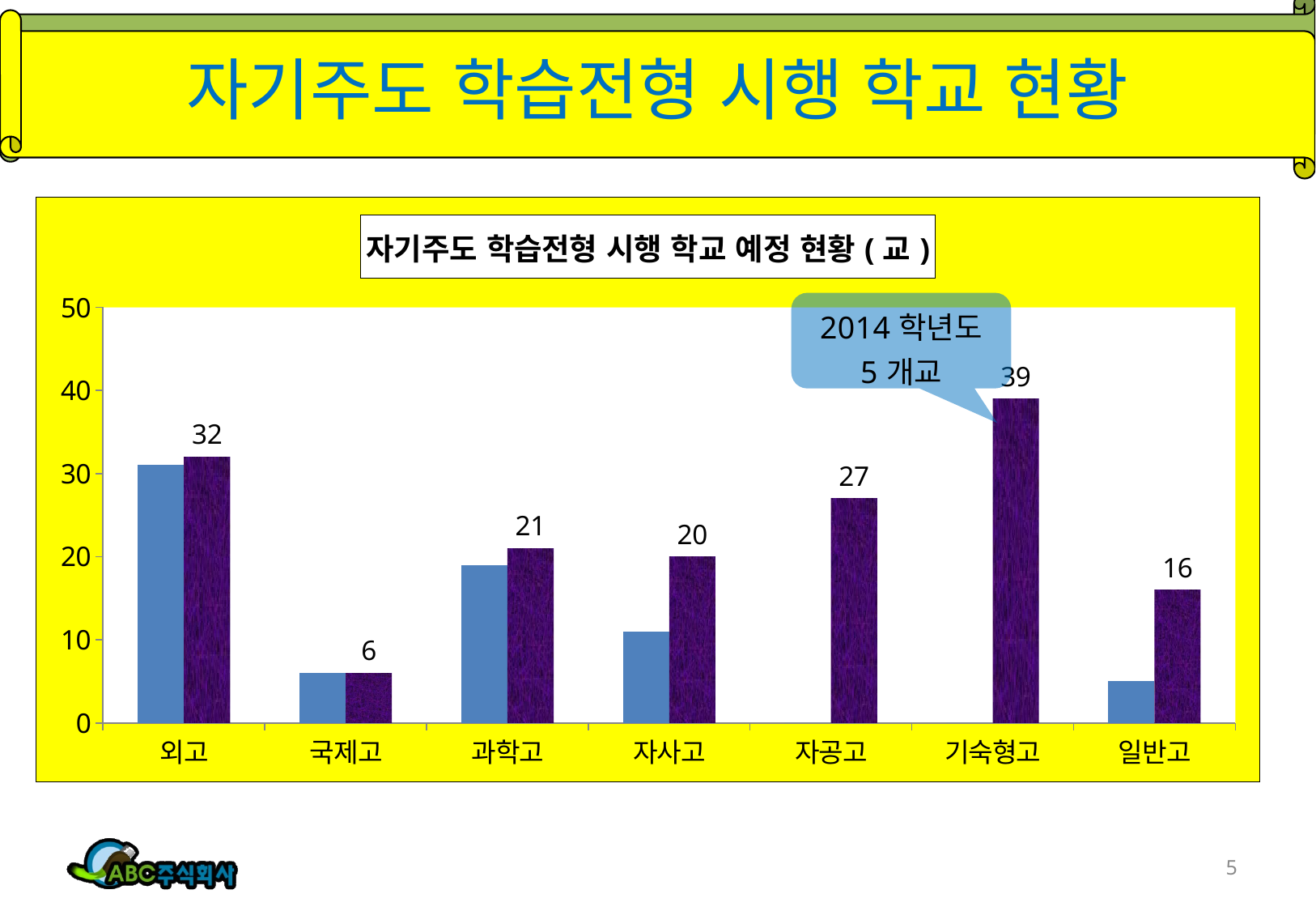
What is the value of the purple bar for 외고? 32 Which category has the lowest purple bar? 국제고 What is the value of the purple bar for 기숙형고? 39 Which has the larger purple bar value, 과학고 or 자사고? 과학고 What is the value of the purple bar for 일반고? 16 What type of chart is shown on the slide? bar chart Is the value of the blue bar for 자사고 greater or less than 20? less Which category has the highest purple bar? 기숙형고 What is the value of the purple bar for 국제고? 6 How many categories are shown on the x axis? 7 What is the difference between the purple bar values for 기숙형고 and 자공고? 12